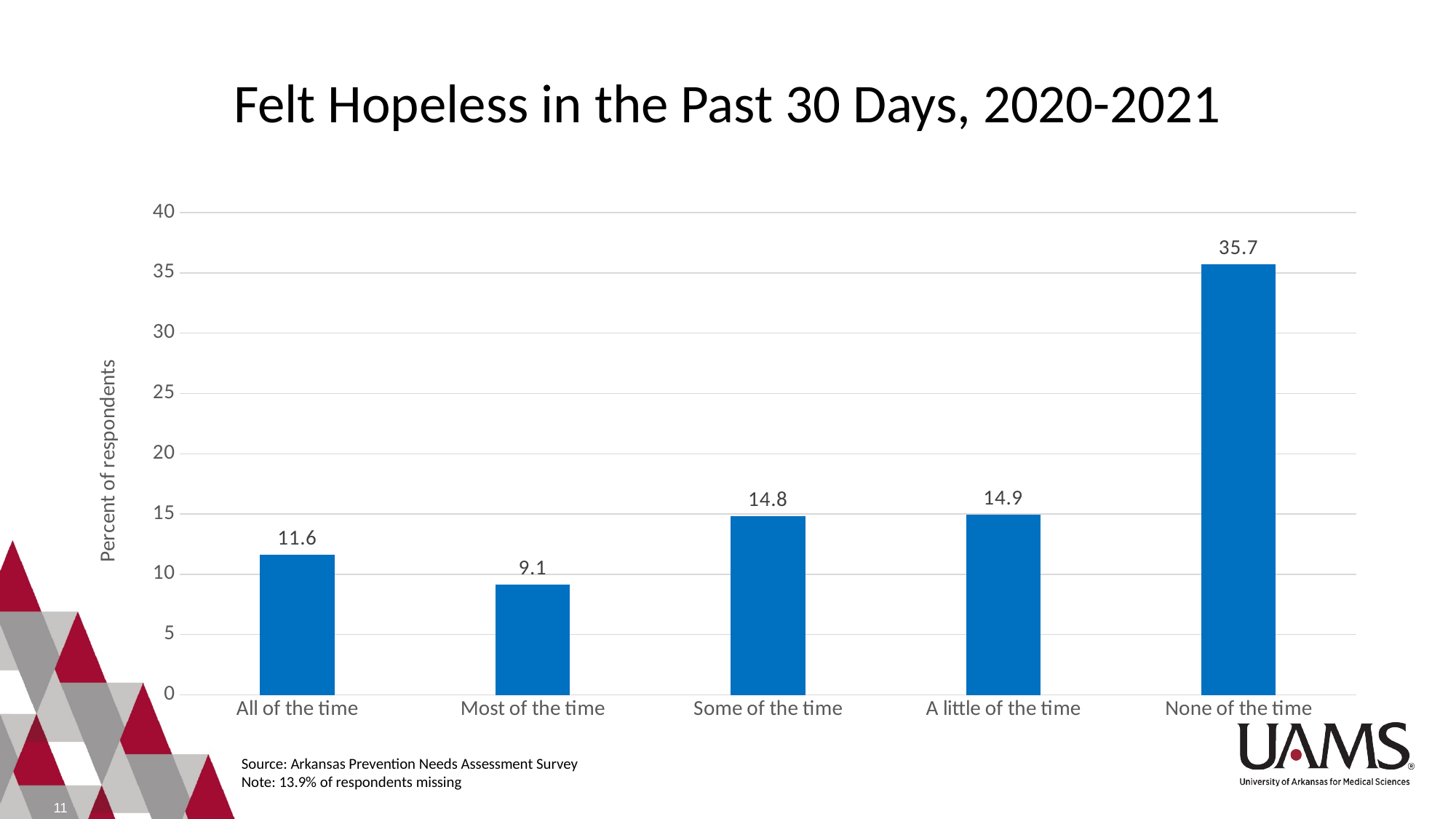
Which category has the lowest value? Most of the time Which is larger, the value for "All of the time" or the value for "Some of the time"? Some of the time How many categories are shown on the x axis? 5 What is the value for "All of the time"? 11.6 Is the value for "None of the time" greater or less than 30? greater What is the value for "Most of the time"? 9.1 What kind of chart is shown on the slide? Bar chart What is the value for "Some of the time"? 14.8 What is the difference between the values for "All of the time" and "Most of the time"? 2.5 What is the value for "None of the time"? 35.7 What is the difference between the values for "None of the time" and "A little of the time"? 20.8 Which category has the highest value? None of the time